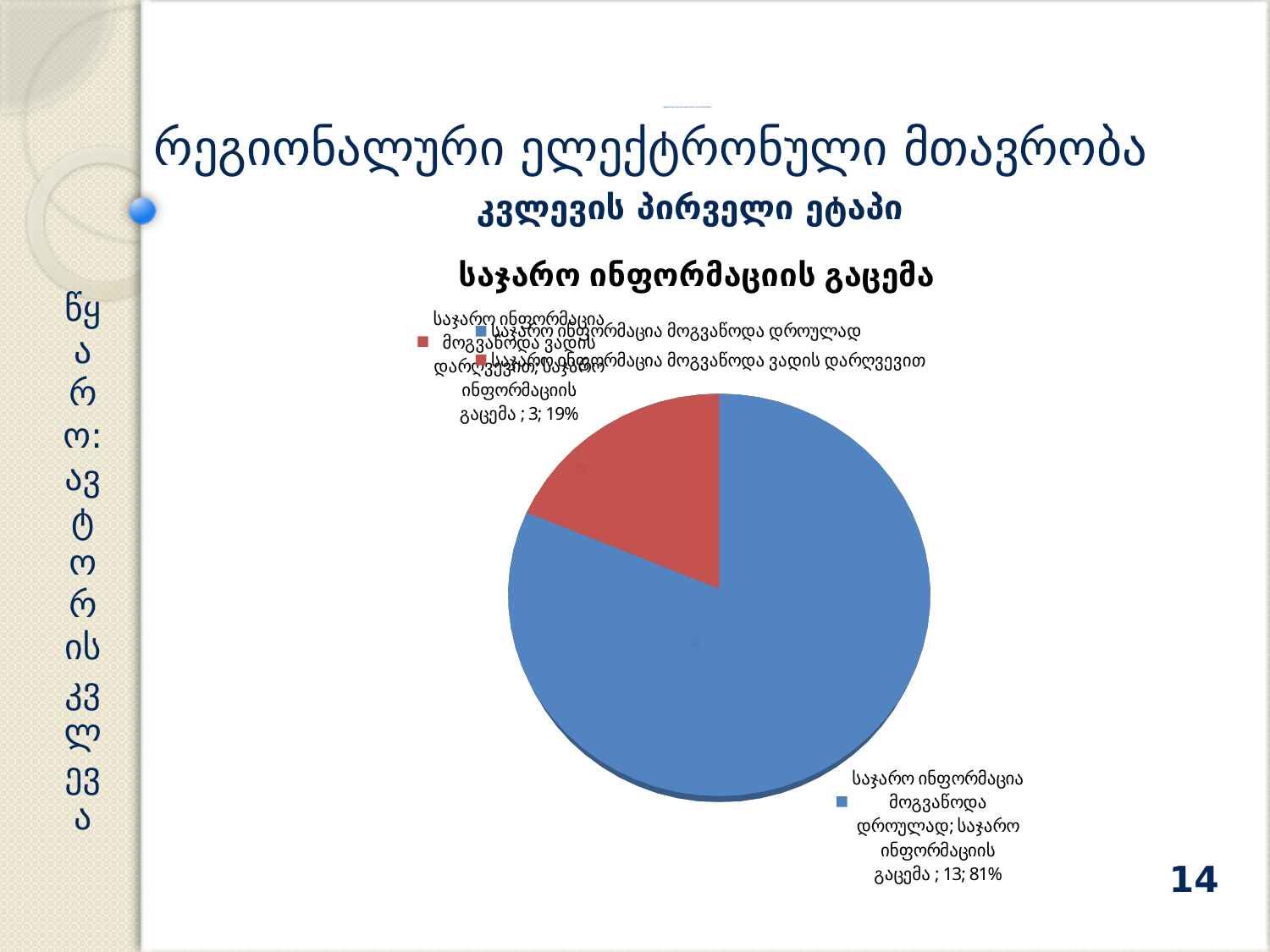
Which slice of the pie is the largest? საჯარო ინფორმაცია მოგვაწოდა დროულად What share of the pie does the slice "საჯარო ინფორმაცია მოგვაწოდა ვადის დარღვევით" represent? 19% What colour is the slice for "საჯარო ინფორმაცია მოგვაწოდა ვადის დარღვევით"? red How many entries does the chart legend list? 2 What is the difference between the values of the two slices (13 and 3)? 10 What value is shown for the slice "საჯარო ინფორმაცია მოგვაწოდა დროულად"? 13 What kind of chart is shown on the slide? pie chart How many slices does the pie chart have? 2 Which slice of the pie is the smallest? საჯარო ინფორმაცია მოგვაწოდა ვადის დარღვევით What is the title of the chart? საჯარო ინფორმაციის გაცემა What share of the pie does the slice "საჯარო ინფორმაცია მოგვაწოდა დროულად" represent? 81% What value is shown for the slice "საჯარო ინფორმაცია მოგვაწოდა ვადის დარღვევით"? 3